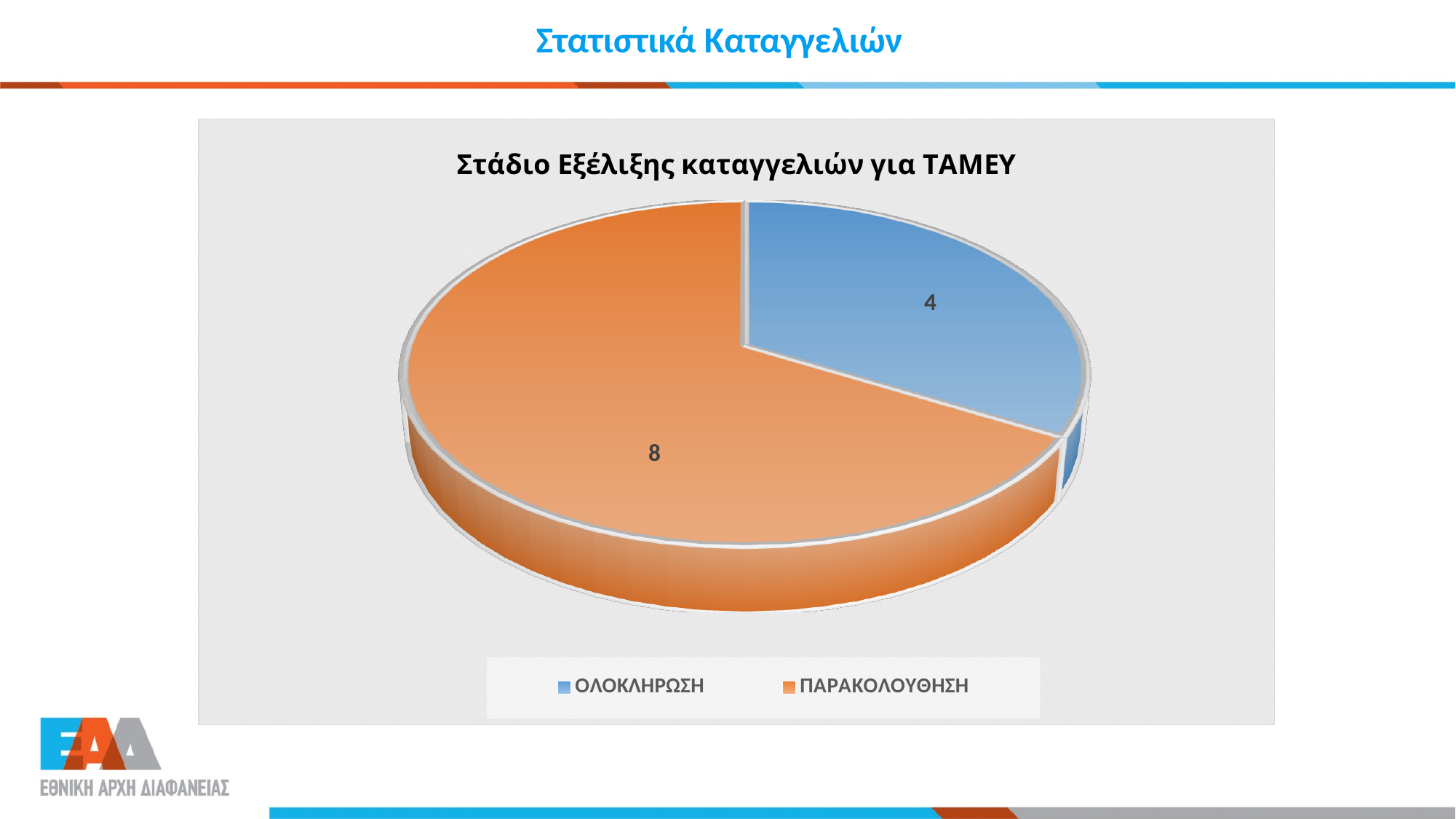
How many slices does the pie chart have? 2 What is the difference between the values for ΠΑΡΑΚΟΛΟΥΘΗΣΗ and ΟΛΟΚΛΗΡΩΣΗ? 4 What kind of chart is shown on the slide? pie chart How many entries does the legend list? 2 Which category has the smallest slice? ΟΛΟΚΛΗΡΩΣΗ Which is larger, the value for ΟΛΟΚΛΗΡΩΣΗ or the value for ΠΑΡΑΚΟΛΟΥΘΗΣΗ? ΠΑΡΑΚΟΛΟΥΘΗΣΗ What share of the pie does ΟΛΟΚΛΗΡΩΣΗ represent? one third What is the value for ΟΛΟΚΛΗΡΩΣΗ? 4 What is the total of all slices in the pie chart? 12 What is the value for ΠΑΡΑΚΟΛΟΥΘΗΣΗ? 8 What is the title of the chart? Στάδιο Εξέλιξης καταγγελιών για ΤΑΜΕΥ Which category has the largest slice? ΠΑΡΑΚΟΛΟΥΘΗΣΗ